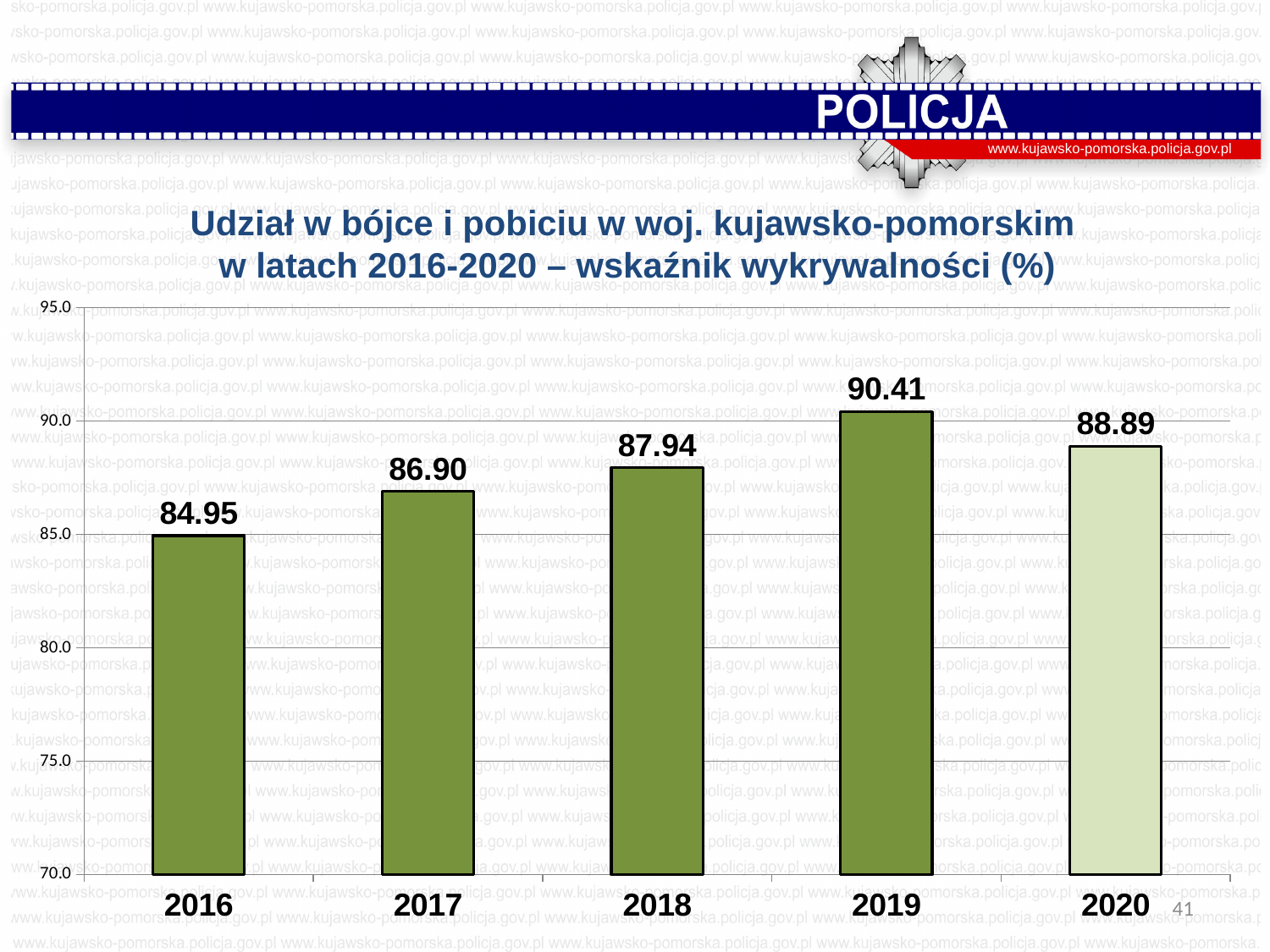
What is the detection rate value shown for 2019? 90.41 What is the difference between the 2019 and 2016 values? 5.46 Do the values rise or fall from 2016 to 2019? rise What is the detection rate value shown for 2020? 88.89 What is the detection rate value shown for 2016? 84.95 What is the difference between the 2018 and 2017 values? 1.04 How many years are shown on the chart? 5 Which is larger, the value for 2020 or the value for 2018? 2020 Which year has the highest detection rate? 2019 Is the value for 2017 greater or less than 85.0? greater What kind of chart is shown on the slide? bar chart Which year has the lowest detection rate? 2016